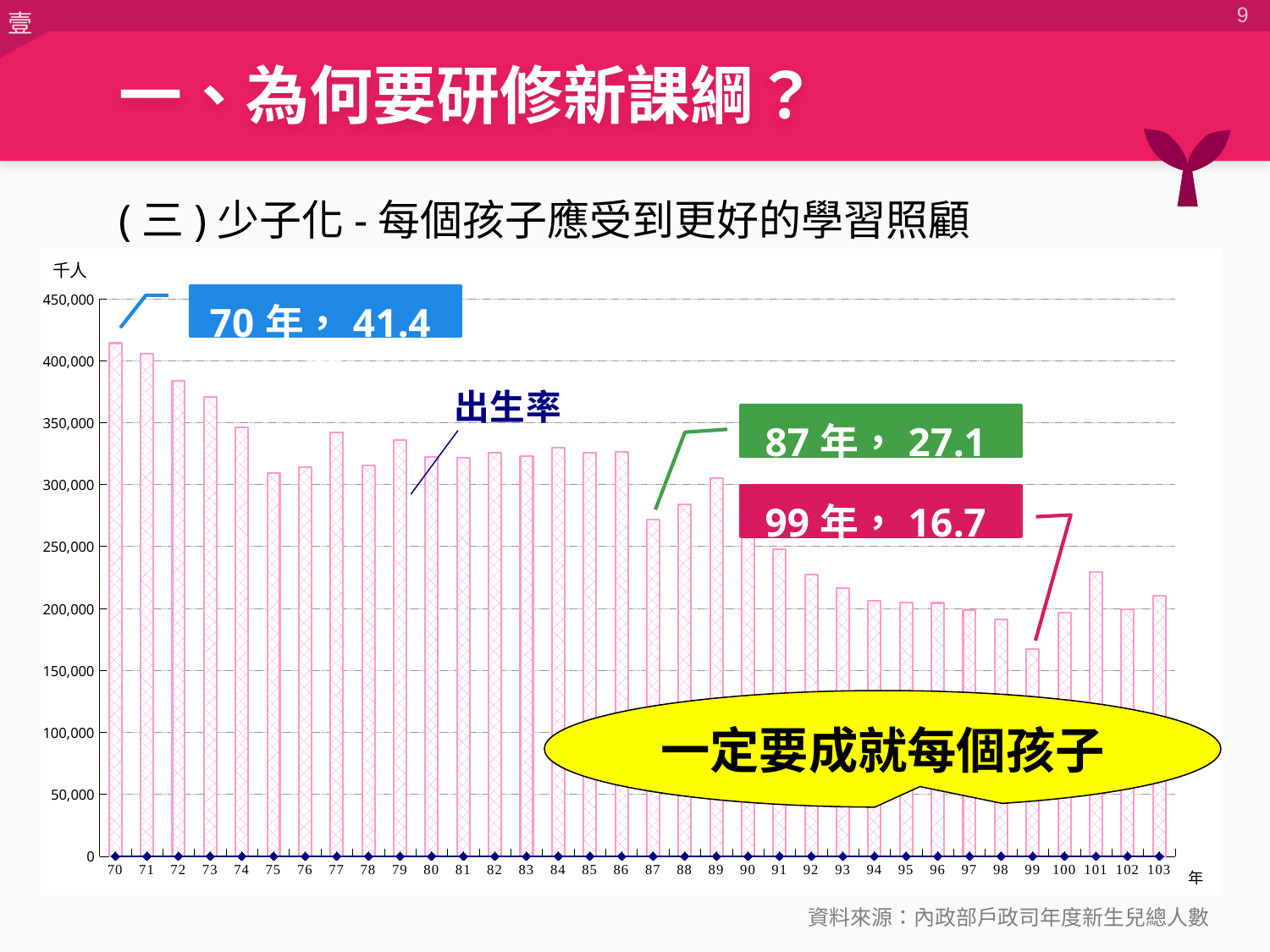
Is the value for year 70 greater or less than 400,000? greater What kind of chart is shown on the slide? combination bar and line chart Overall, do the bar values rise or fall from year 70 to year 103? fall Is the value for year 99 greater or less than 200,000? less Which year has the tallest bar in the chart? 70 Is the value for year 87 greater or less than 250,000? greater Which bar is taller, year 70 or year 103? 70 What unit is shown at the top of the y axis of the chart? 千人 How many years (bars) are plotted on the x axis of the chart? 34 Which year has the shortest bar in the chart? 99 According to the callout on the chart, what is the birth rate (出生率) value shown for year 87? 27.1